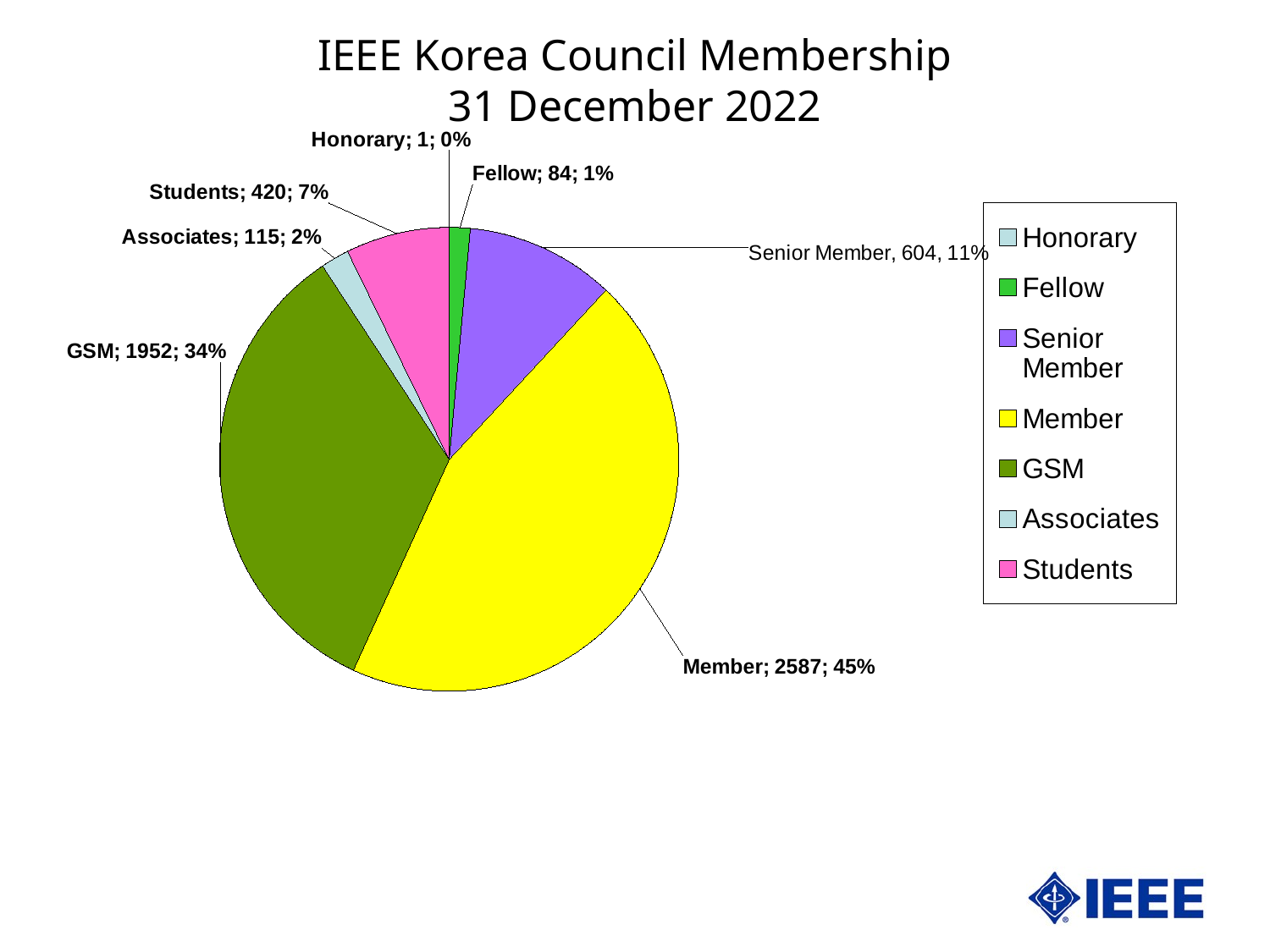
Which category has the largest slice of the pie? Member How many members are in the Member category? 2587 Which category has the smallest slice of the pie? Honorary What percentage share does GSM have? 34% What colour is the Member slice? yellow How many Senior Members are shown? 604 How many categories does the pie chart have? 7 What type of chart is shown on the slide? pie chart Which is larger, the Students count or the Associates count? Students What is the title of the chart? IEEE Korea Council Membership 31 December 2022 What percentage share do Students have? 7% What is the difference in count between Member and GSM? 635